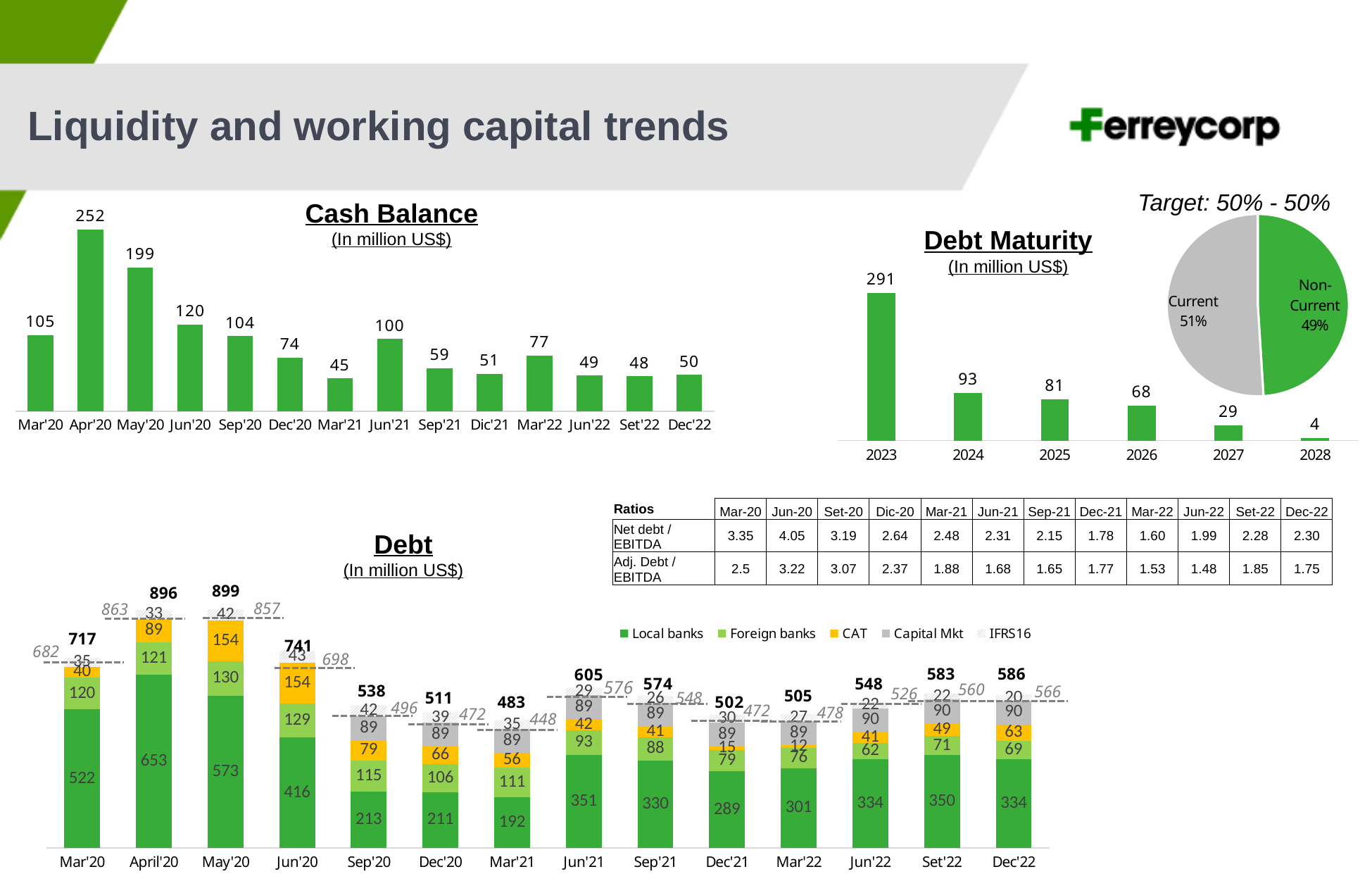
In the Debt Maturity bar chart, which is larger, the value for 2024 or the value for 2025? 2024 In the Debt Maturity bar chart, do the values rise or fall from 2023 to 2028? fall In the Cash Balance chart, which period has the lowest cash balance? Mar'21 How many series does the legend of the Debt chart list? 5 In the Cash Balance chart, what is the difference between the values for Apr'20 and May'20? 53 In the Debt Maturity bar chart, what is the value for 2023? 291 How many periods are shown on the x axis of the Cash Balance chart? 14 In the Cash Balance chart, which period has the highest cash balance? Apr'20 In the Debt chart, what is the Local banks value for Dec'22? 334 In the Debt chart, what is the total of the stacked bar for April'20? 896 In the Cash Balance chart, what is the value for Apr'20? 252 In the Debt Maturity pie chart, what share is Current? 51%